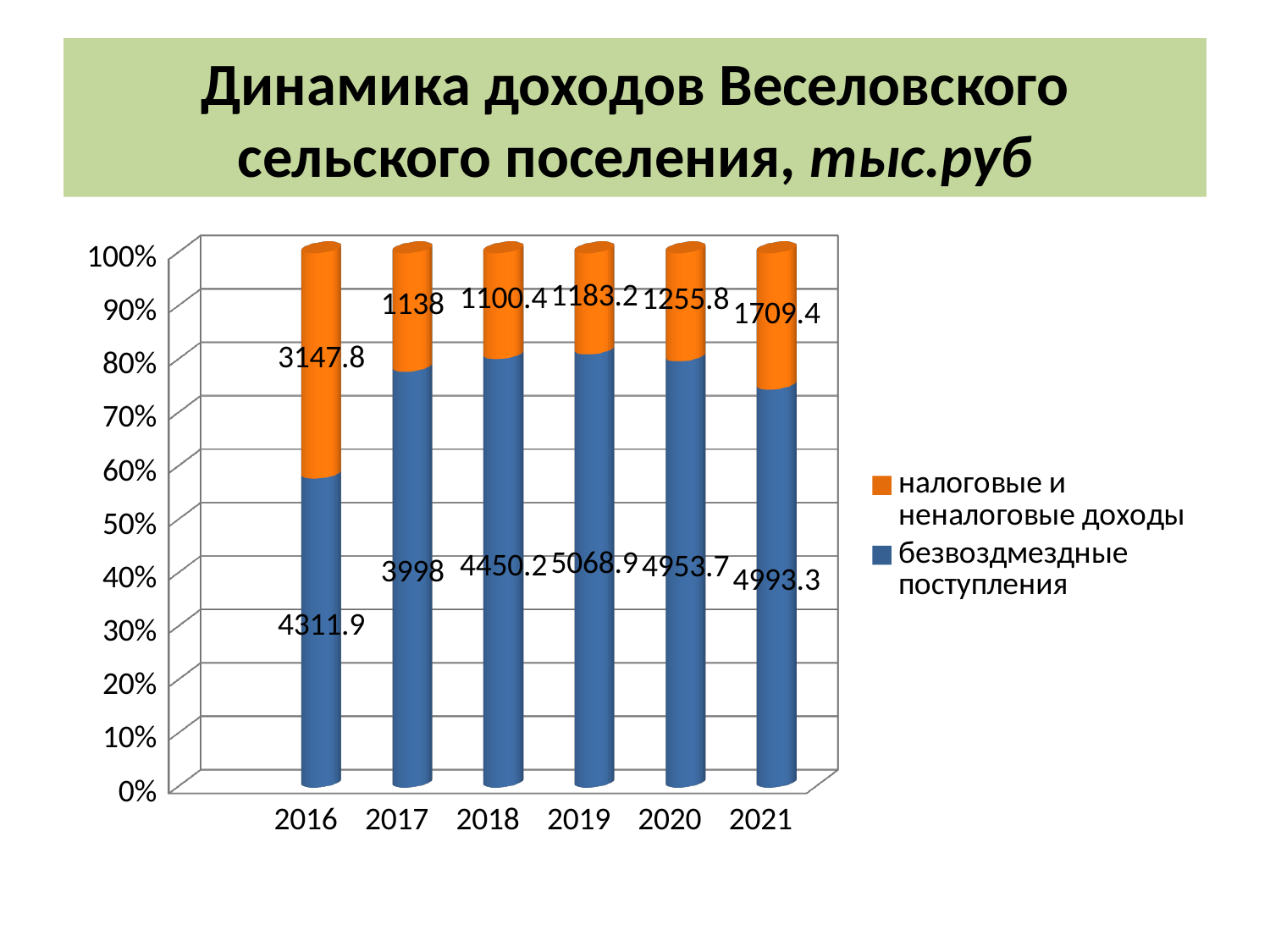
What is the value of безвозмездные поступления for 2016? 4311.9 What is the difference between налоговые и неналоговые доходы in 2021 and in 2020? 453.6 In which year is the value of безвозмездные поступления the lowest? 2017 What is the value of налоговые и неналоговые доходы for 2021? 1709.4 How many years are shown on the x axis? 6 In which year is the value of налоговые и неналоговые доходы the highest? 2016 What kind of chart is shown on the slide? stacked bar chart Which is larger: безвозмездные поступления in 2019 or in 2020? 2019 In which year is the value of налоговые и неналоговые доходы the lowest? 2018 What is the total of the two series for 2017? 5136 What is the value of безвозмездные поступления for 2019? 5068.9 How many series does the legend list? 2